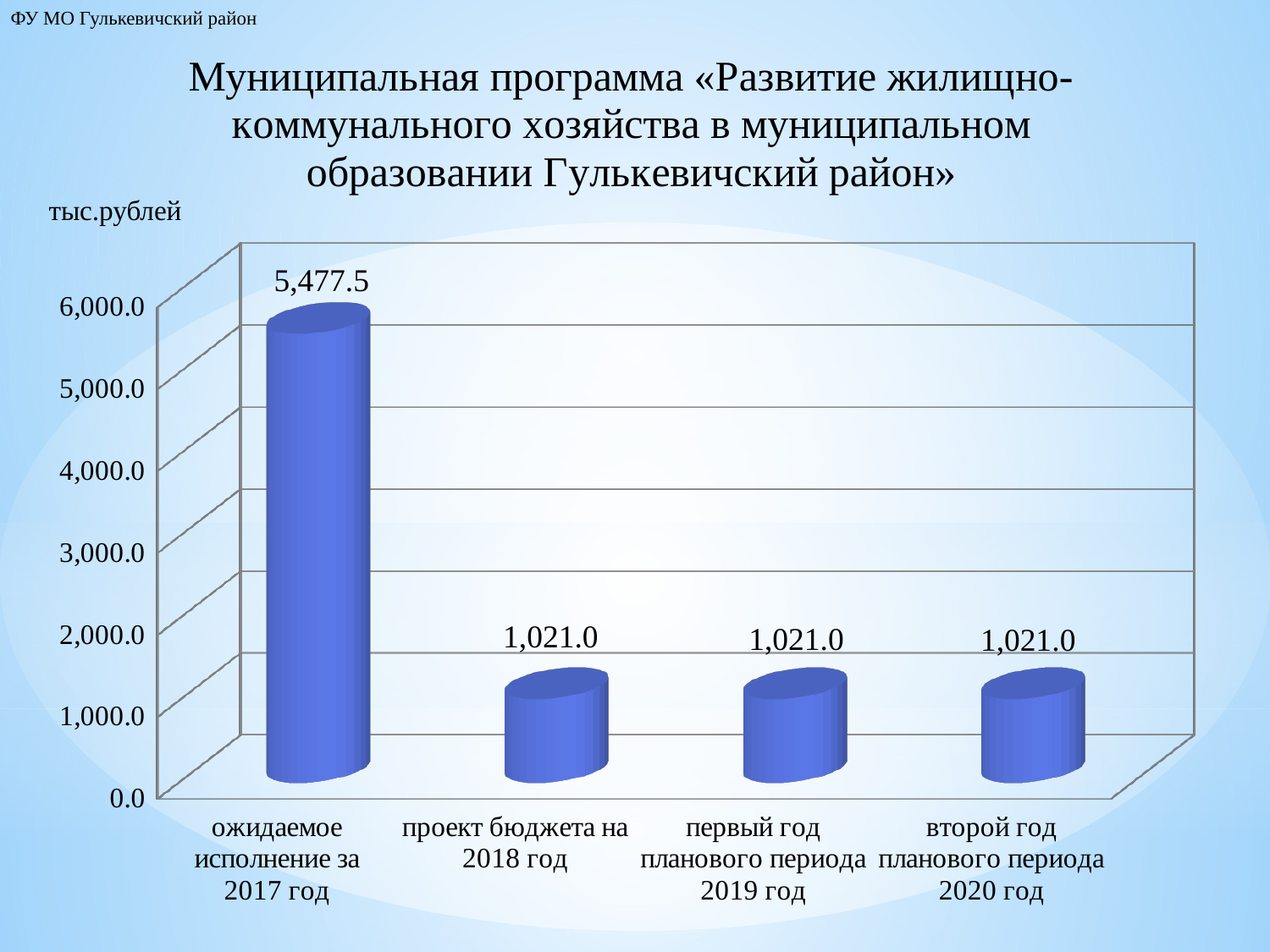
What kind of chart is shown on the slide? bar chart What is the difference between the value for ожидаемое исполнение за 2017 год and the value for проект бюджета на 2018 год? 4,456.5 What is the value for второй год планового периода 2020 год? 1,021.0 Is the value for первый год планового периода 2019 год greater or less than 2,000.0? less What is the value for ожидаемое исполнение за 2017 год? 5,477.5 Which is larger: the value for ожидаемое исполнение за 2017 год or the value for первый год планового периода 2019 год? ожидаемое исполнение за 2017 год What unit is indicated above the chart's vertical axis? тыс.рублей How many categories are shown on the chart? 4 Do the values rise or fall from the first category to the second category along the x axis? fall What is the value for проект бюджета на 2018 год? 1,021.0 Is the value for ожидаемое исполнение за 2017 год greater or less than 5,000.0? greater Which category has the highest value? ожидаемое исполнение за 2017 год